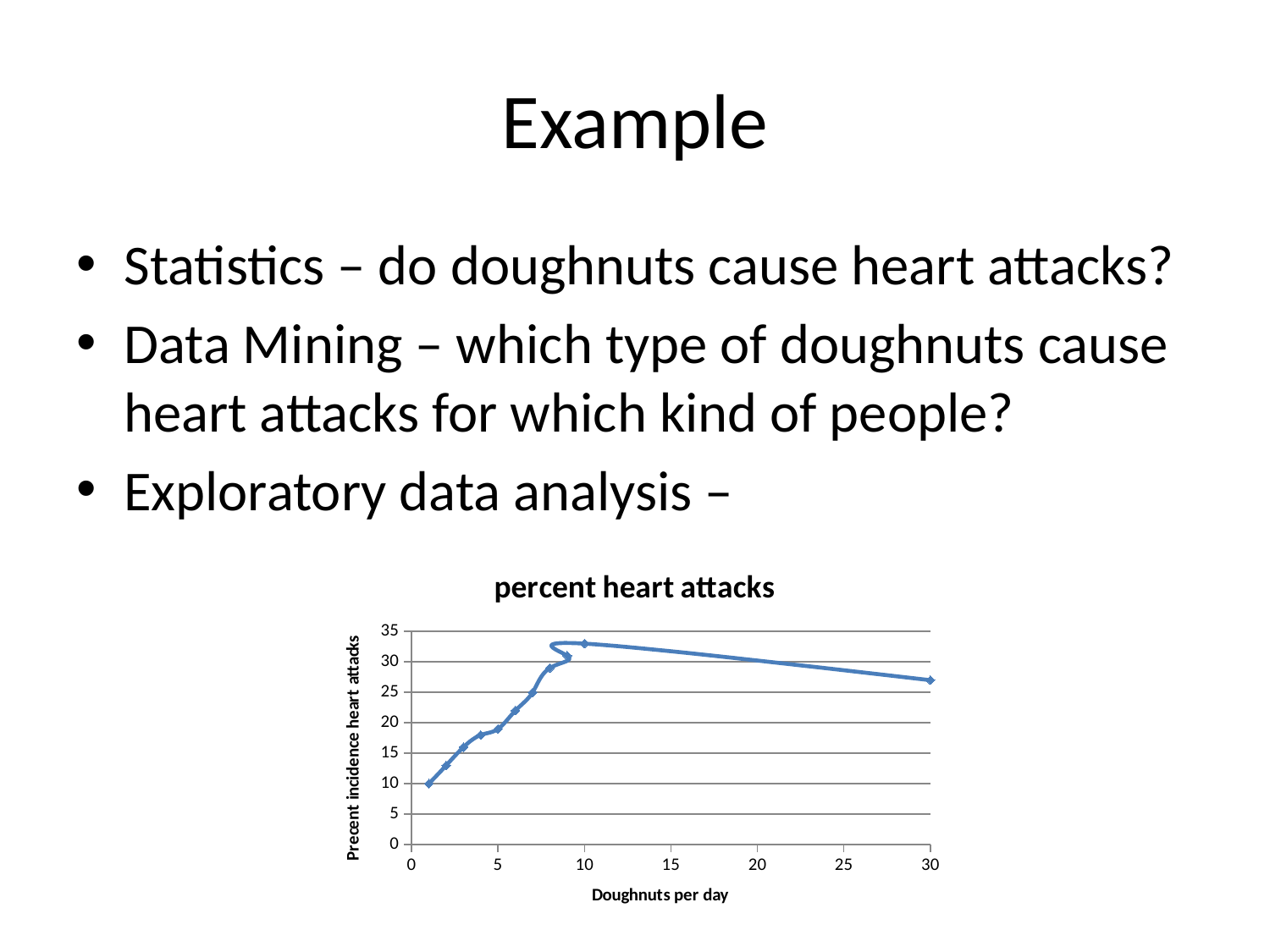
Is the value for 30 doughnuts per day greater or less than 30? less Do the values rise or fall as doughnuts per day increase from 1 to 10? rise What is the label of the x axis of the chart? Doughnuts per day Is the value for 1 doughnut per day greater or less than 15? less Which is larger, the value for 10 doughnuts per day or the value for 30 doughnuts per day? 10 doughnuts per day What is the title of the chart? percent heart attacks At which number of doughnuts per day is the percent incidence of heart attacks lowest? 1 What kind of chart is shown on the slide? line chart Is the value for 10 doughnuts per day greater or less than 30? greater Do the values rise or fall as doughnuts per day increase from 10 to 30? fall